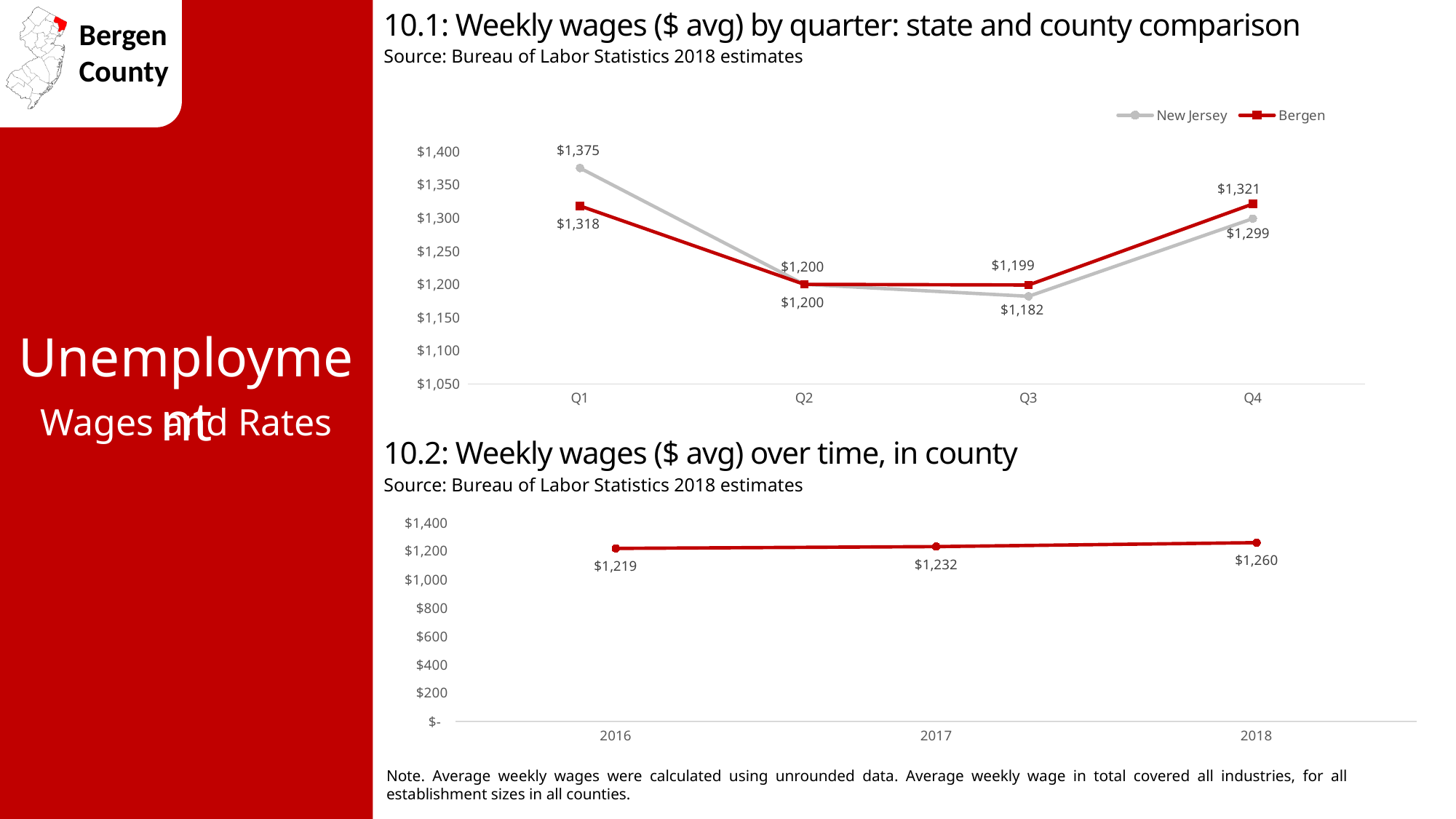
In chart 10.1, what is the New Jersey weekly wage in Q3? $1,182 In chart 10.1, what is the difference between the New Jersey and Bergen weekly wages in Q1? $57 In chart 10.1, what is the Bergen weekly wage in Q4? $1,321 In chart 10.1, which is larger in Q4, the New Jersey or the Bergen weekly wage? Bergen In chart 10.1, which quarter has the highest Bergen weekly wage? Q4 In chart 10.1, how many series does the legend list? 2 In chart 10.1, what is the New Jersey weekly wage in Q1? $1,375 In chart 10.1, what colour is the Bergen line? Red In chart 10.2, what is the weekly wage in 2017? $1,232 In chart 10.2, do weekly wages rise or fall from 2016 to 2018? Rise In chart 10.2, what is the difference between the 2018 and 2016 weekly wages? $41 In chart 10.1, which quarter has the lowest New Jersey weekly wage? Q3